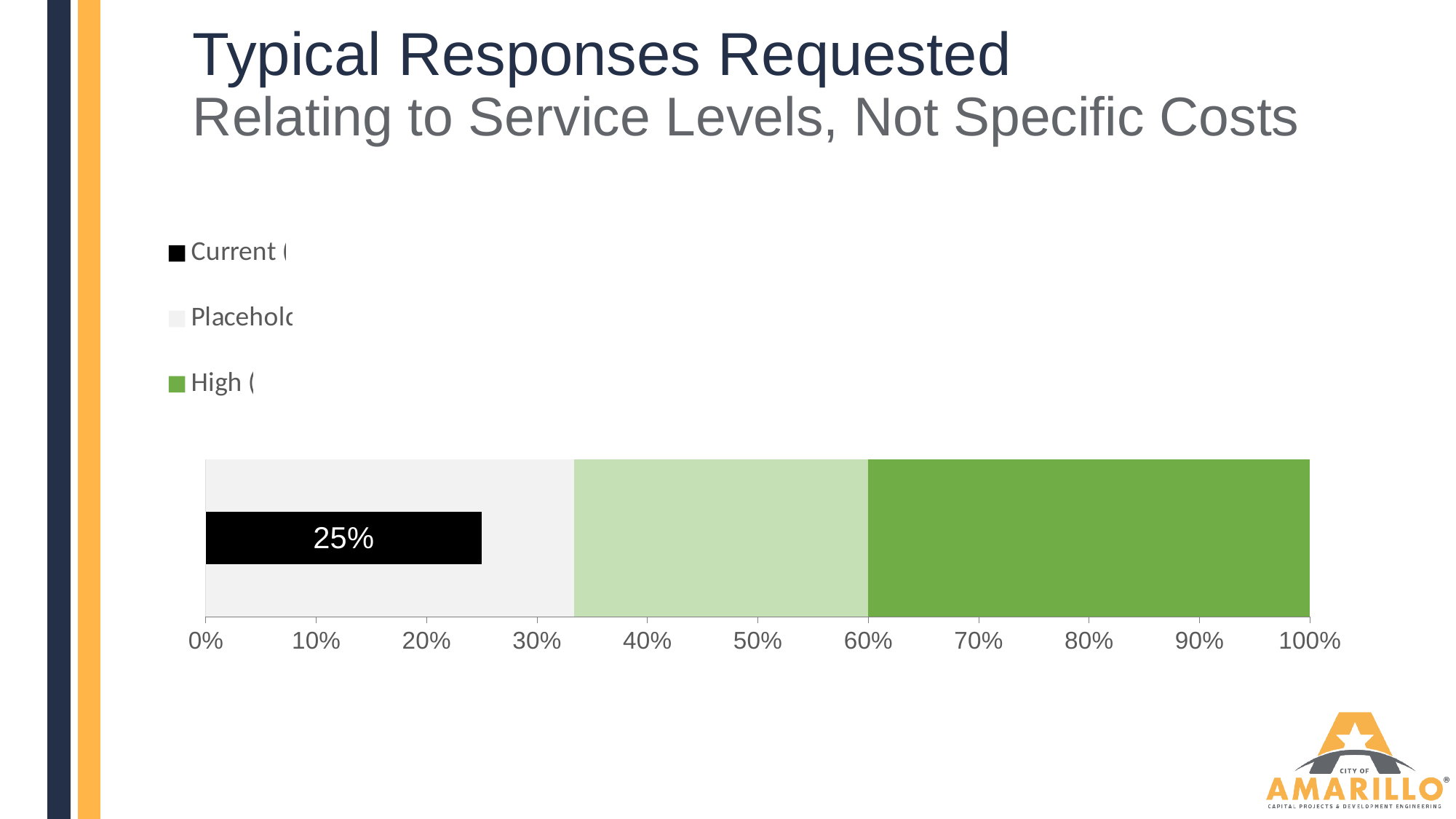
What is the highest value shown on the chart's horizontal axis? 100% What colour is the legend marker for the entry beginning with "High"? green What kind of chart is shown on the slide? bar chart Is the black bar oriented horizontally or vertically? horizontally Is the value of the black bar greater or less than 20%? greater How many entries does the chart's legend list? 3 What value is printed on the black bar in the chart? 25% Is the value of the black bar greater or less than 30%? less